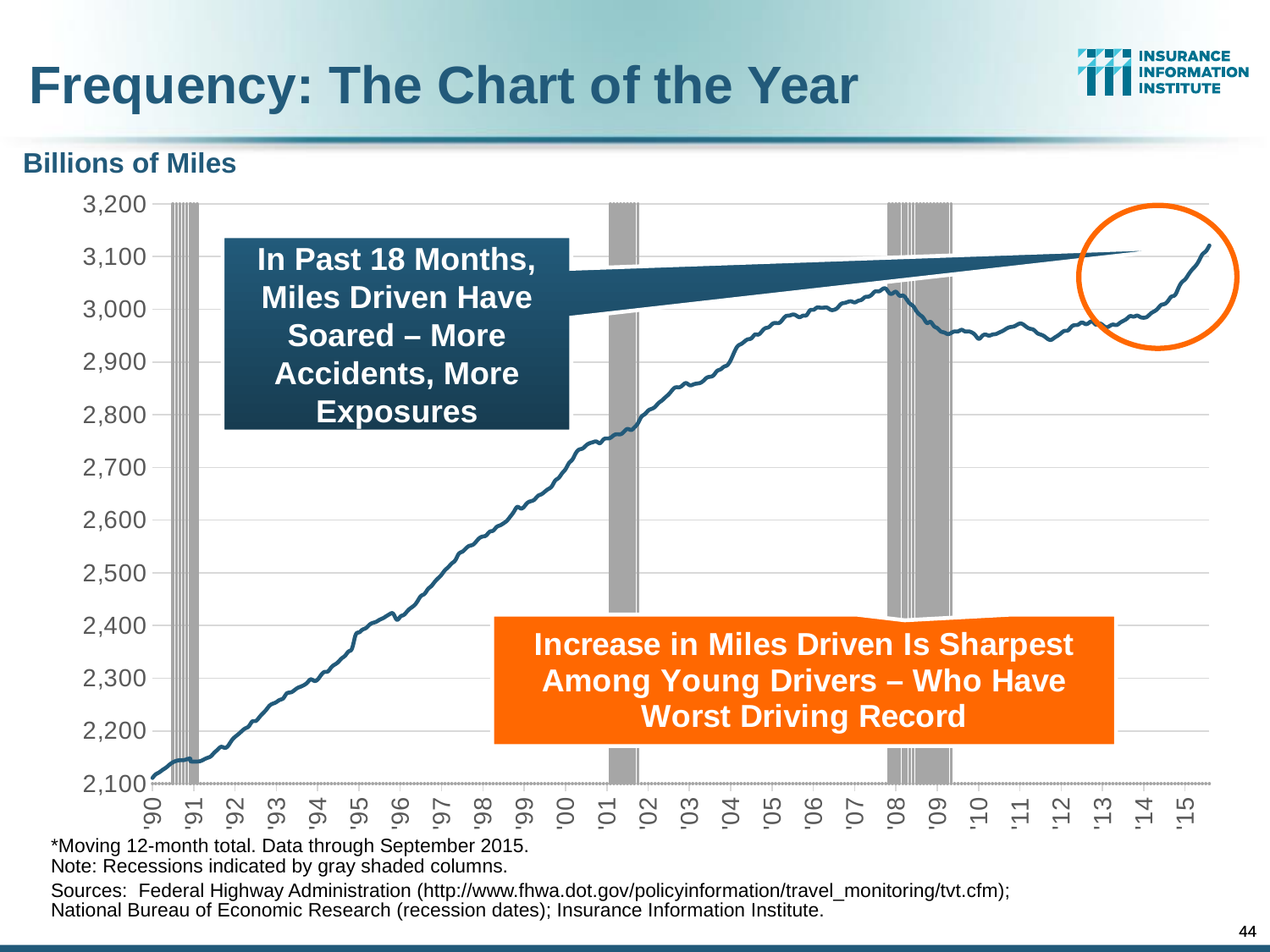
What unit is the y axis measured in, according to the label above the chart? Billions of Miles Is the value at '97 greater or less than 2,400? greater What kind of chart is shown on the slide? line chart Which is higher, the value at '00 or the value at '05? '05 Do the values in the chart generally rise or fall from '90 to '15? rise Is the value at '05 greater or less than 2,900? greater Which is higher, the value at '08 or the value at '10? '08 Is the value at '90 greater or less than 2,200? less How many year labels are shown on the x axis? 26 What do the gray shaded columns in the chart indicate? Recessions